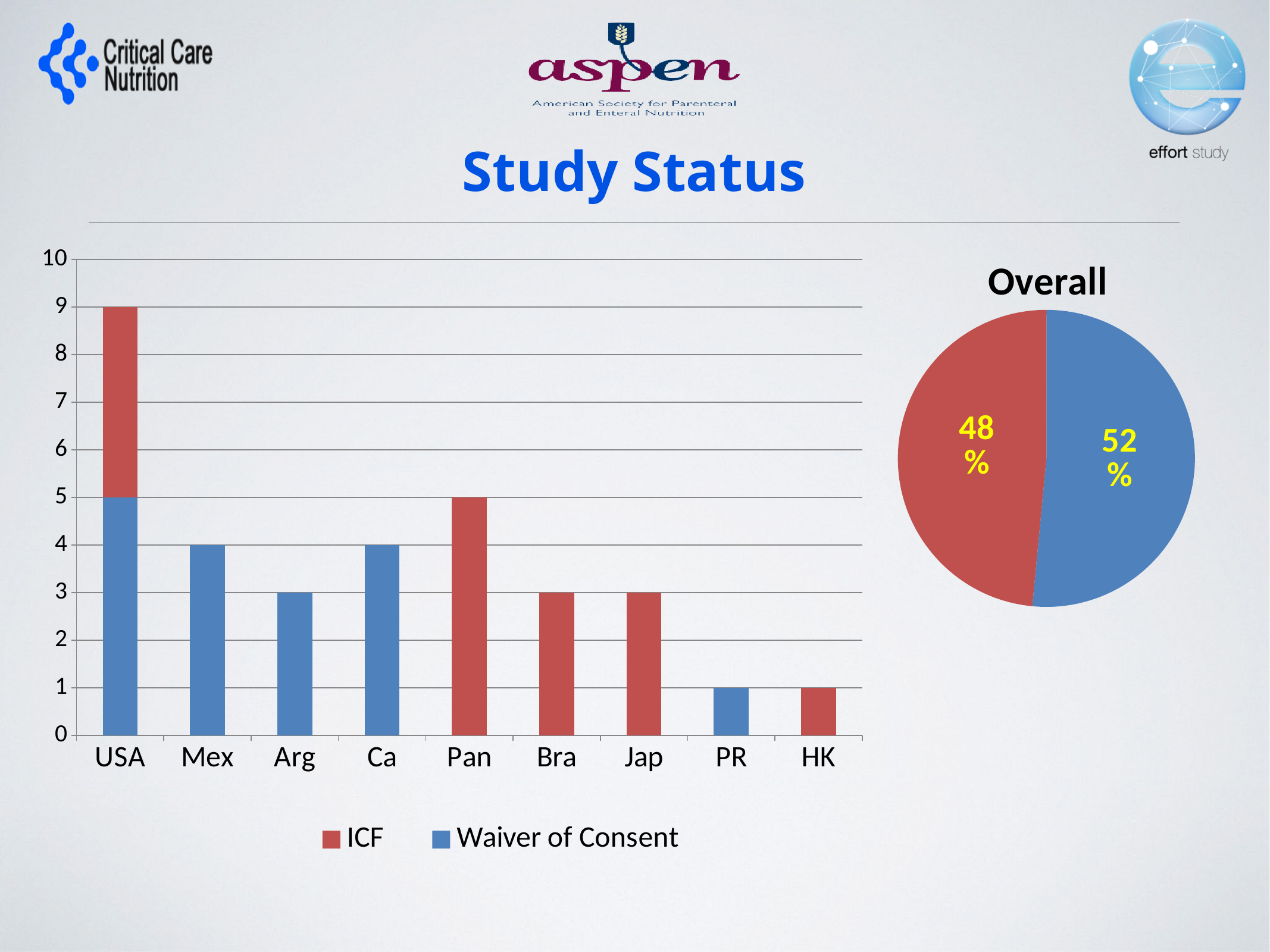
What kind of chart is the chart on the left of the slide? bar chart In the bar chart on the left, what is the difference between the Waiver of Consent values for Arg and PR? 2 In the bar chart on the left, what is the total height of the stacked bar for USA? 9 In the pie chart titled "Overall", what share does the blue (Waiver of Consent) slice have? 52% In the bar chart on the left, which category has the tallest bar? USA In the bar chart on the left, how many categories are shown on the x axis? 9 What kind of chart is the chart titled "Overall"? pie chart In the bar chart on the left, what is the ICF value for Pan? 5 In the bar chart on the left, what is the Waiver of Consent value for Mex? 4 In the bar chart on the left, which series is shown in red according to the legend? ICF In the bar chart on the left, how many series does the legend list? 2 In the bar chart on the left, which is larger: the ICF value for Bra or the ICF value for HK? Bra